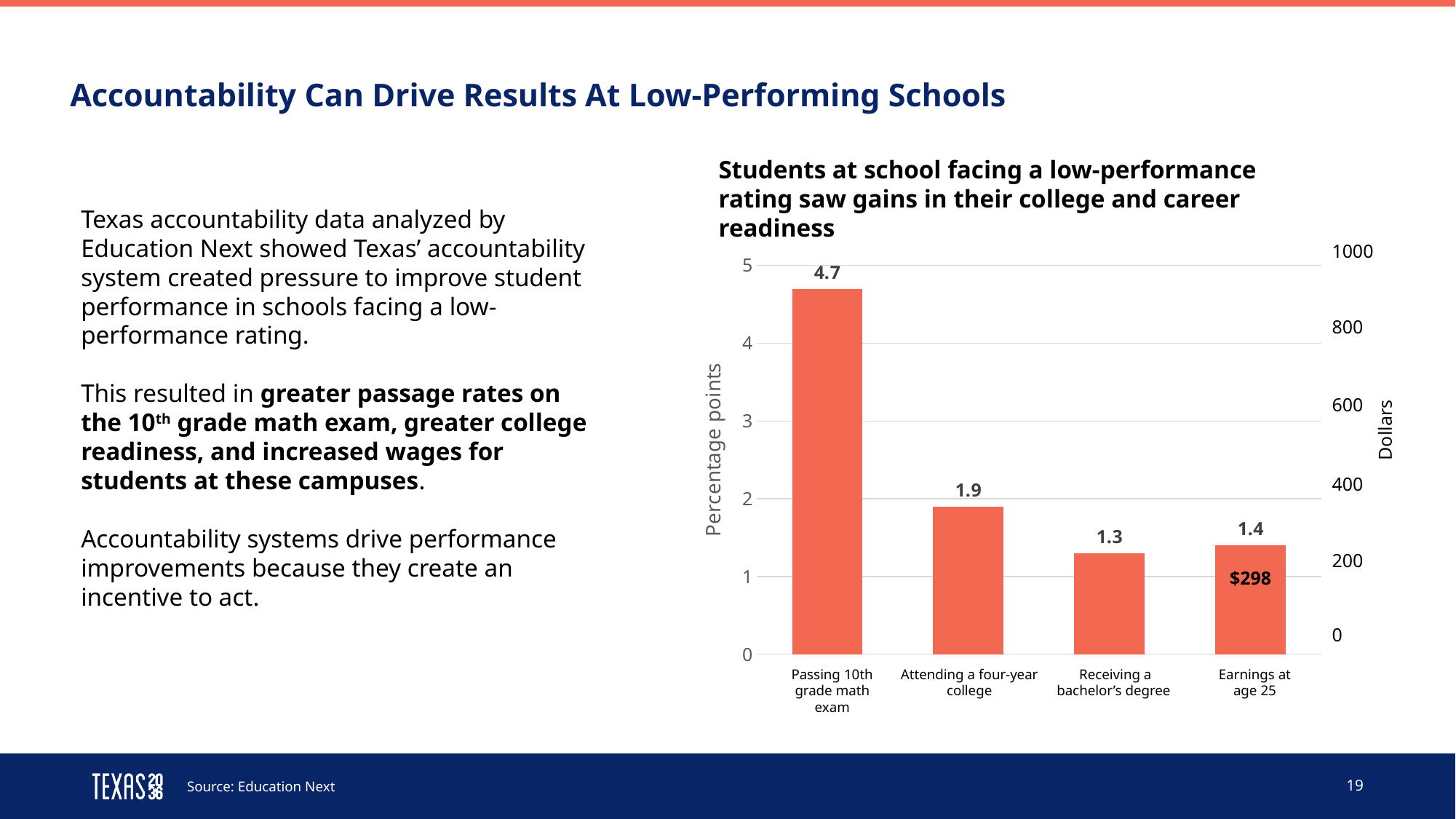
What is the value for Attending a four-year college? 1.9 Which category has the highest bar? Passing 10th grade math exam What is the value for Receiving a bachelor's degree? 1.3 Which category has the lowest bar? Receiving a bachelor's degree What is the label of the left vertical axis? Percentage points What dollar amount is labeled on the Earnings at age 25 bar? $298 What kind of chart is shown on the slide? bar chart What is the value for Passing 10th grade math exam? 4.7 Is the value for Passing 10th grade math exam greater or less than 4? greater How many categories are shown on the x axis? 4 What is the difference between the values for Passing 10th grade math exam and Attending a four-year college? 2.8 Which is larger, the value for Attending a four-year college or the value for Receiving a bachelor's degree? Attending a four-year college